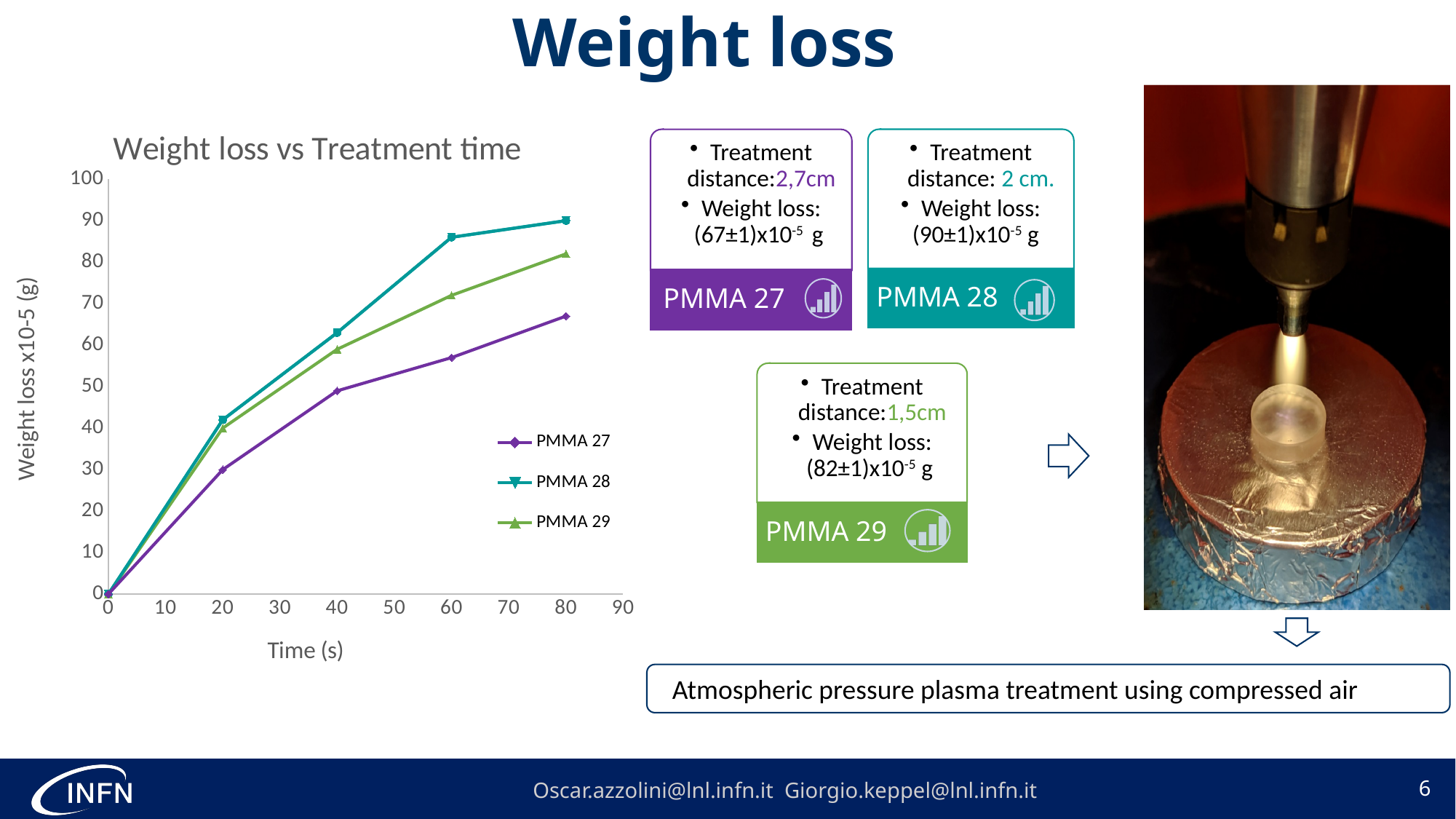
What is the title of the chart? Weight loss vs Treatment time Is the weight loss for PMMA 27 at 20 s greater or less than 40? less Is the weight loss for PMMA 29 at 40 s greater or less than 50? greater At 60 s, which series has the larger weight loss, PMMA 28 or PMMA 29? PMMA 28 Which series has the highest weight loss at 80 s? PMMA 28 What type of chart is shown on the slide? line chart Which series has the lowest weight loss at 80 s? PMMA 27 How many series does the chart legend list? 3 How many data points are plotted for the PMMA 28 series? 5 Is the weight loss for PMMA 28 at 80 s greater or less than 80? greater Do the weight loss values rise or fall as treatment time increases? rise What is the label of the x axis? Time (s)